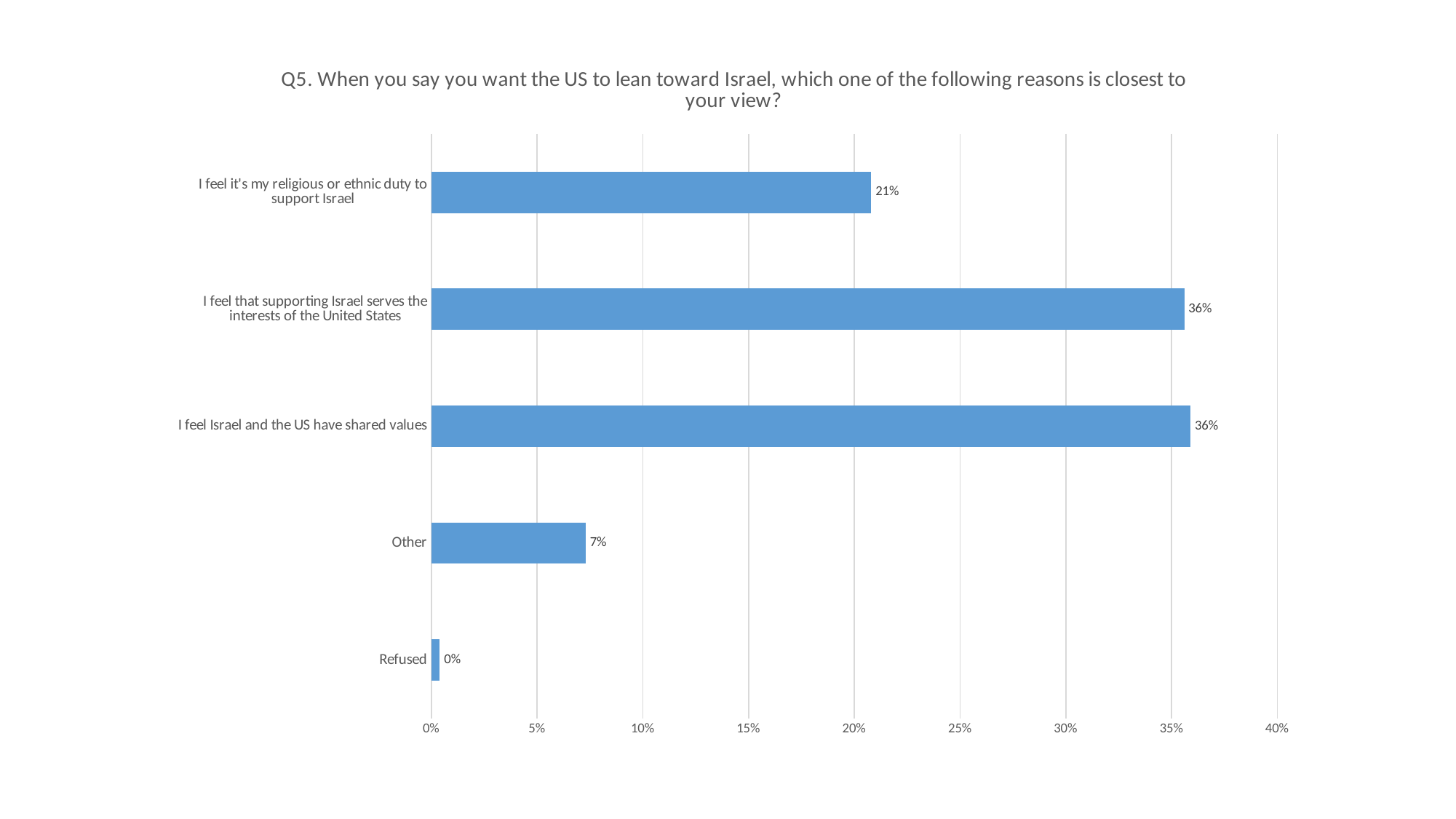
What is the difference between the value for "I feel Israel and the US have shared values" and the value for "I feel it's my religious or ethnic duty to support Israel"? 15% What is the value for "Refused"? 0% How many categories are shown in the chart? 5 Which category has the lowest value? Refused What is the value for "I feel that supporting Israel serves the interests of the United States"? 36% What kind of chart is shown on the slide? bar chart What is the value for "Other"? 7% What is the title of the chart? Q5. When you say you want the US to lean toward Israel, which one of the following reasons is closest to your view? What is the value for "I feel it's my religious or ethnic duty to support Israel"? 21% Which is larger: the value for "I feel that supporting Israel serves the interests of the United States" or the value for "Other"? I feel that supporting Israel serves the interests of the United States What is the value for "I feel Israel and the US have shared values"? 36% What is the difference between the value for "I feel it's my religious or ethnic duty to support Israel" and the value for "Other"? 14%